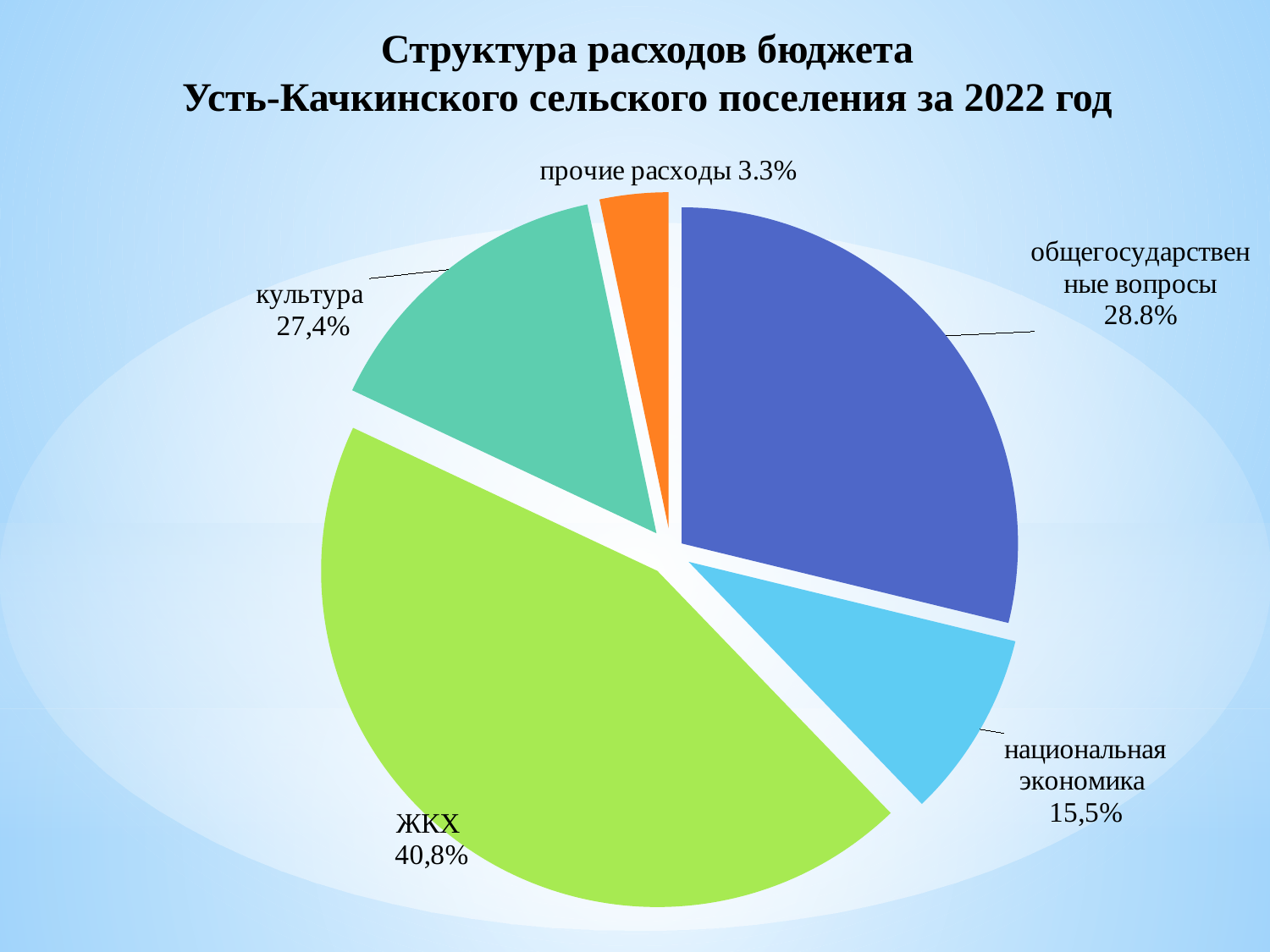
What year does the chart title say the budget expenditure structure is for? 2022 Which is larger: the share for общегосударственные вопросы or the share for культура? общегосударственные вопросы What share of budget expenditure is общегосударственные вопросы? 28.8% What share of budget expenditure is культура? 27,4% How many categories are shown in the pie chart? 5 What type of chart is shown on the slide? pie chart Which category has the largest share of the budget expenditure? ЖКХ What share of budget expenditure is ЖКХ? 40,8% What share of budget expenditure is прочие расходы? 3.3% What share of budget expenditure is национальная экономика? 15,5% What is the difference in percentage points between the share for ЖКХ and the share for культура? 13,4 Which category has the smallest share of the budget expenditure? прочие расходы